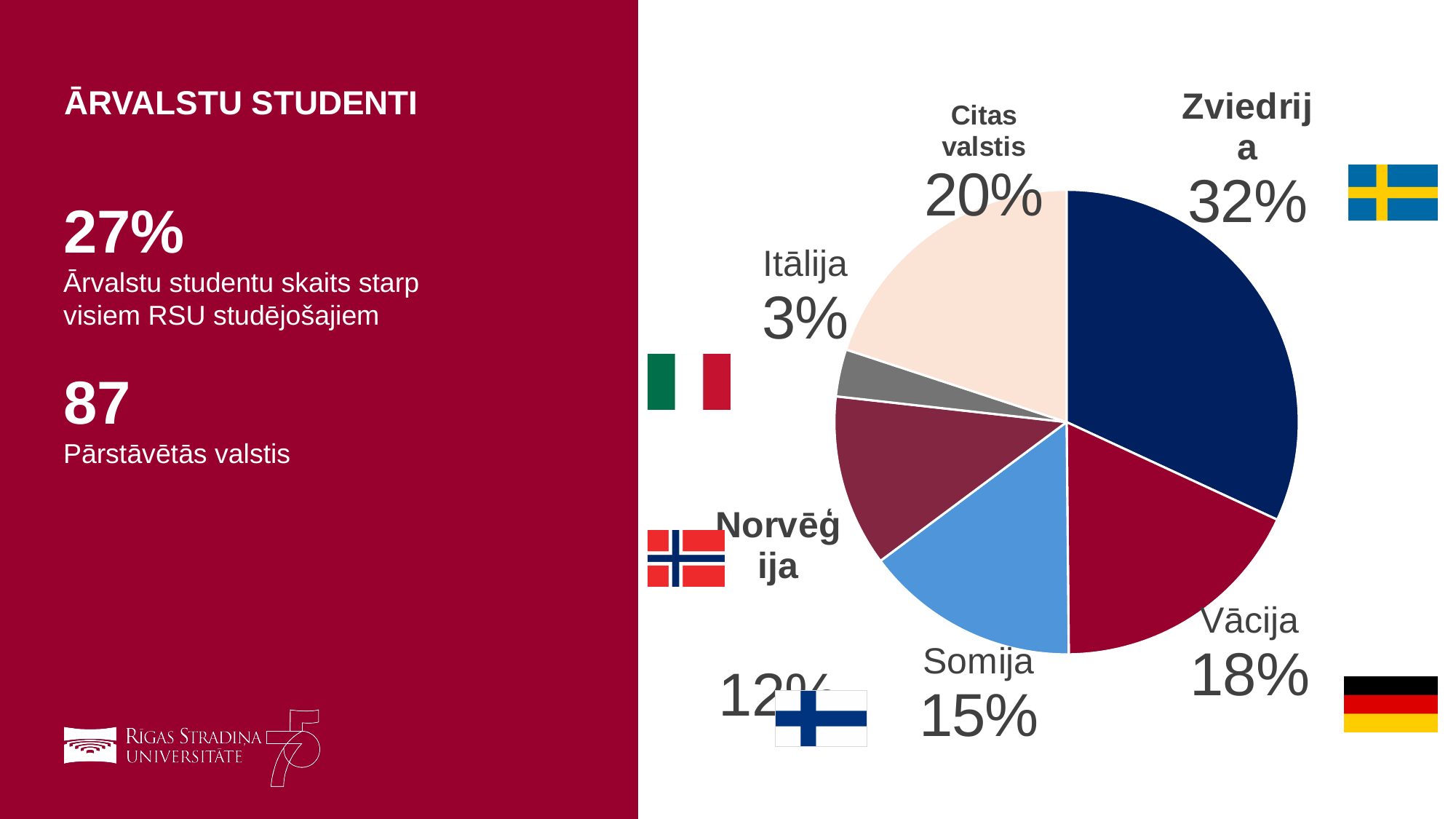
What percentage is shown for Somija? 15% What percentage is shown for Itālija? 3% What colour is the Zviedrija slice? Dark navy blue Which category has the smallest slice of the pie? Itālija How many slices does the pie chart have? 6 How many percentage points larger is Zviedrija's share than Vācija's? 14 percentage points Which has a larger share, Somija or Vācija? Vācija What percentage is shown for Vācija? 18% What share of the pie is labelled Citas valstis? 20% What share of the pie does Zviedrija have? 32% Which category has the largest slice of the pie? Zviedrija What kind of chart is shown on the slide? Pie chart